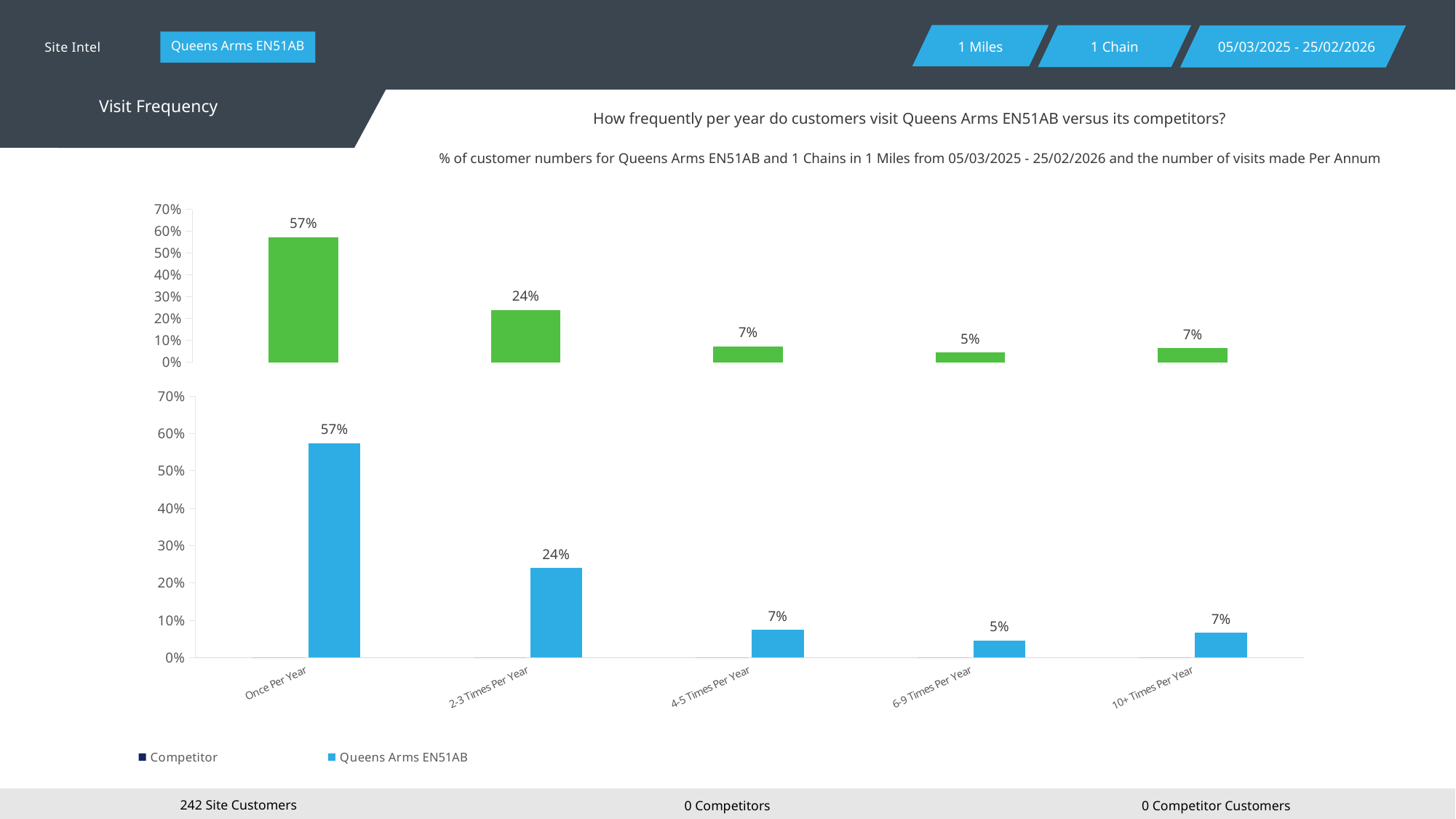
What is the highest value shown in the top chart? 57% In the bottom chart, is the value for 2-3 Times Per Year greater or less than 30%? less In the bottom chart, what is the value for Once Per Year? 57% How many series does the legend list? 2 In the bottom chart, what is the difference between the values for Once Per Year and 2-3 Times Per Year? 33% In the bottom chart, what is the value for 2-3 Times Per Year? 24% In the bottom chart, which is larger, the value for 4-5 Times Per Year or 6-9 Times Per Year? 4-5 Times Per Year How many categories are shown on the x axis of the bottom chart? 5 In the bottom chart, what is the value for 6-9 Times Per Year? 5% What kind of chart is the bottom chart? bar chart In the bottom chart, which category has the highest value? Once Per Year In the bottom chart, which category has the lowest value? 6-9 Times Per Year